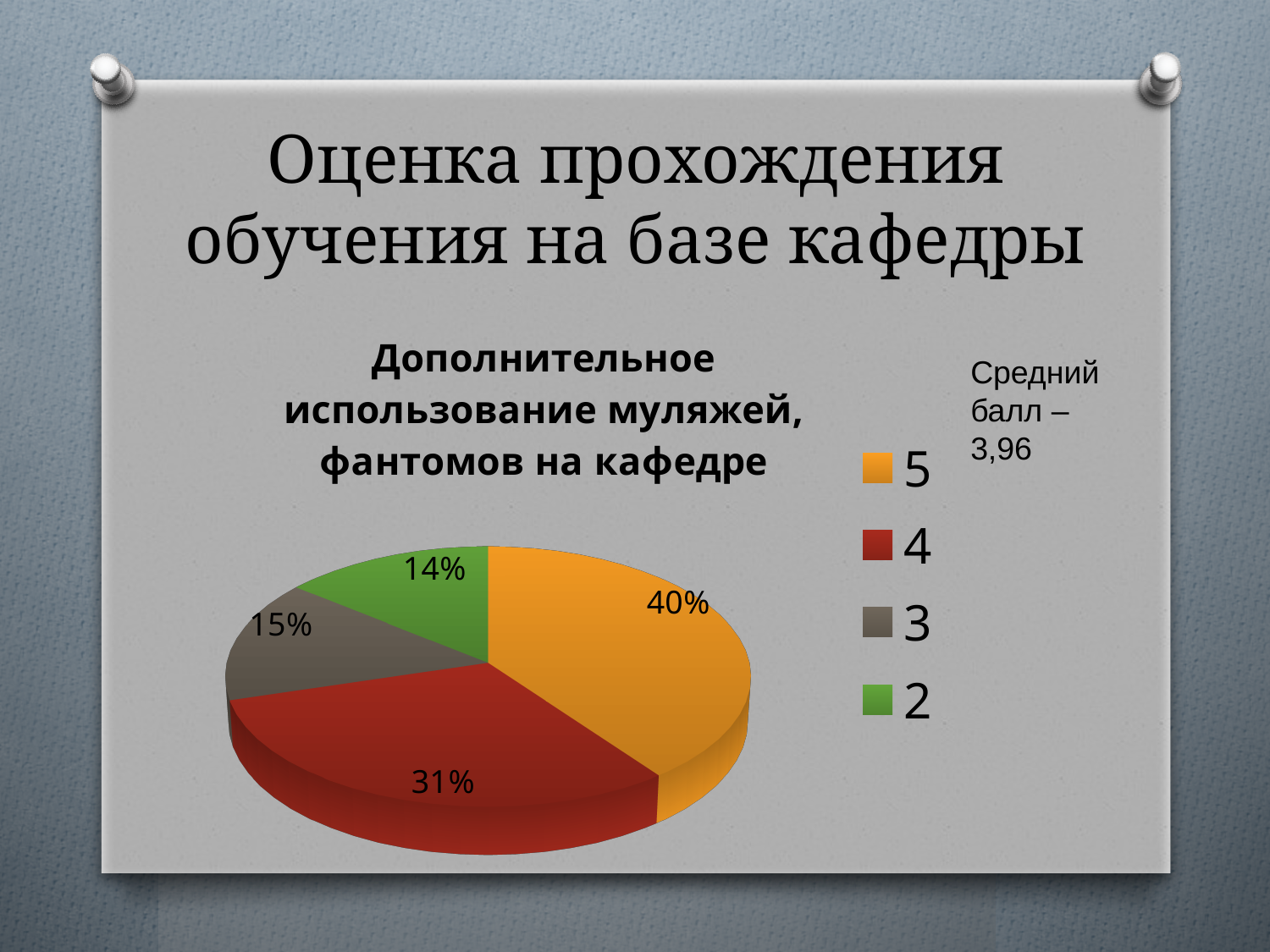
What share of the pie does the rating 4 take? 31% What share of the pie does the rating 2 take? 14% Which has a larger share, rating 4 or rating 3? 4 What colour is the slice for rating 2? green What share of the pie does the rating 5 take? 40% Which rating has the largest share of the pie? 5 What is the difference in percentage points between the shares for rating 5 and rating 4? 9 How many categories does the legend list? 4 What kind of chart is shown on the slide? pie chart Which rating has the smallest share of the pie? 2 What is the chart's title? Дополнительное использование муляжей, фантомов на кафедре